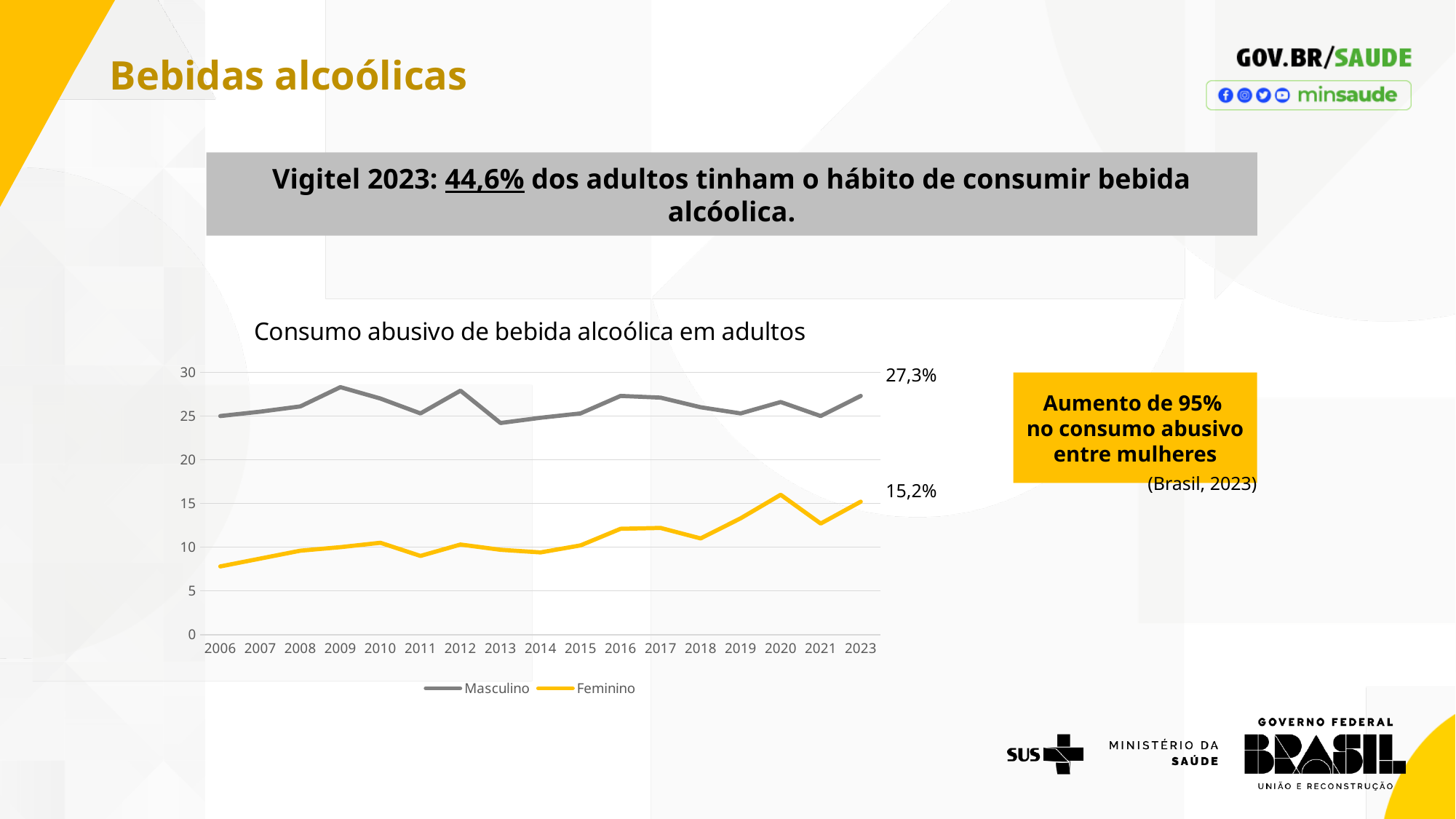
How many years are shown on the x axis of the chart? 17 What is the title of the chart? Consumo abusivo de bebida alcoólica em adultos What is the difference between the Masculino and Feminino values in 2023? 12,1 In which year is the Feminino value lowest? 2006 In 2023, which series has the larger value, Masculino or Feminino? Masculino What kind of chart is shown on the slide? line chart Does the Feminino line generally rise or fall from 2006 to 2023? rises What is the value for Feminino in 2023? 15,2% How many series does the chart legend list? 2 What is the value for Masculino in 2023? 27,3% Is the value for Masculino in 2009 greater or less than 25? greater Is the value for Feminino in 2006 greater or less than 10? less